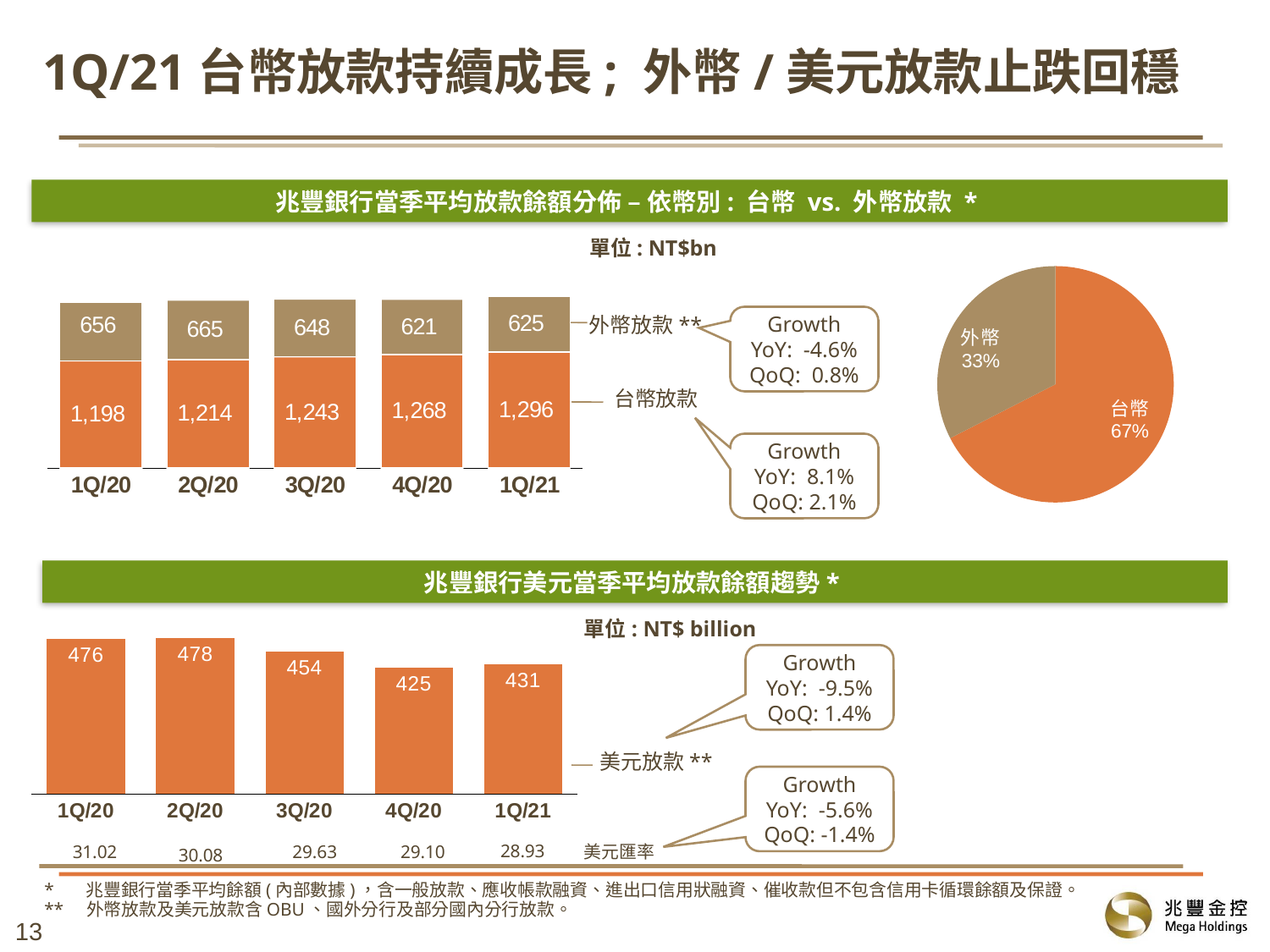
In the top stacked bar chart (台幣 vs. 外幣放款), does the 台幣放款 series rise or fall from 1Q/20 to 1Q/21? rise In the bottom chart (美元當季平均放款餘額趨勢), what is the 美元放款 value for 4Q/20? 425 In the top stacked bar chart (台幣 vs. 外幣放款), what is the 台幣放款 value for 1Q/21? 1,296 What kind of chart is the bottom chart (美元當季平均放款餘額趨勢)? bar chart In the pie chart on the top right, which slice is larger, 台幣 or 外幣? 台幣 In the top stacked bar chart (台幣 vs. 外幣放款), which quarter has the lowest 外幣放款 value? 4Q/20 In the top stacked bar chart (台幣 vs. 外幣放款), what is the 外幣放款 value for 2Q/20? 665 In the bottom chart (美元當季平均放款餘額趨勢), which quarter has the highest 美元放款 value? 2Q/20 In the top stacked bar chart (台幣 vs. 外幣放款), what is the difference between the 台幣放款 values for 1Q/21 and 1Q/20? 98 In the top stacked bar chart (台幣 vs. 外幣放款), what is the total of the 1Q/21 bar? 1,921 In the pie chart on the top right, what share does 外幣 have? 33% In the top stacked bar chart (台幣 vs. 外幣放款), how many quarters are shown on the x axis? 5